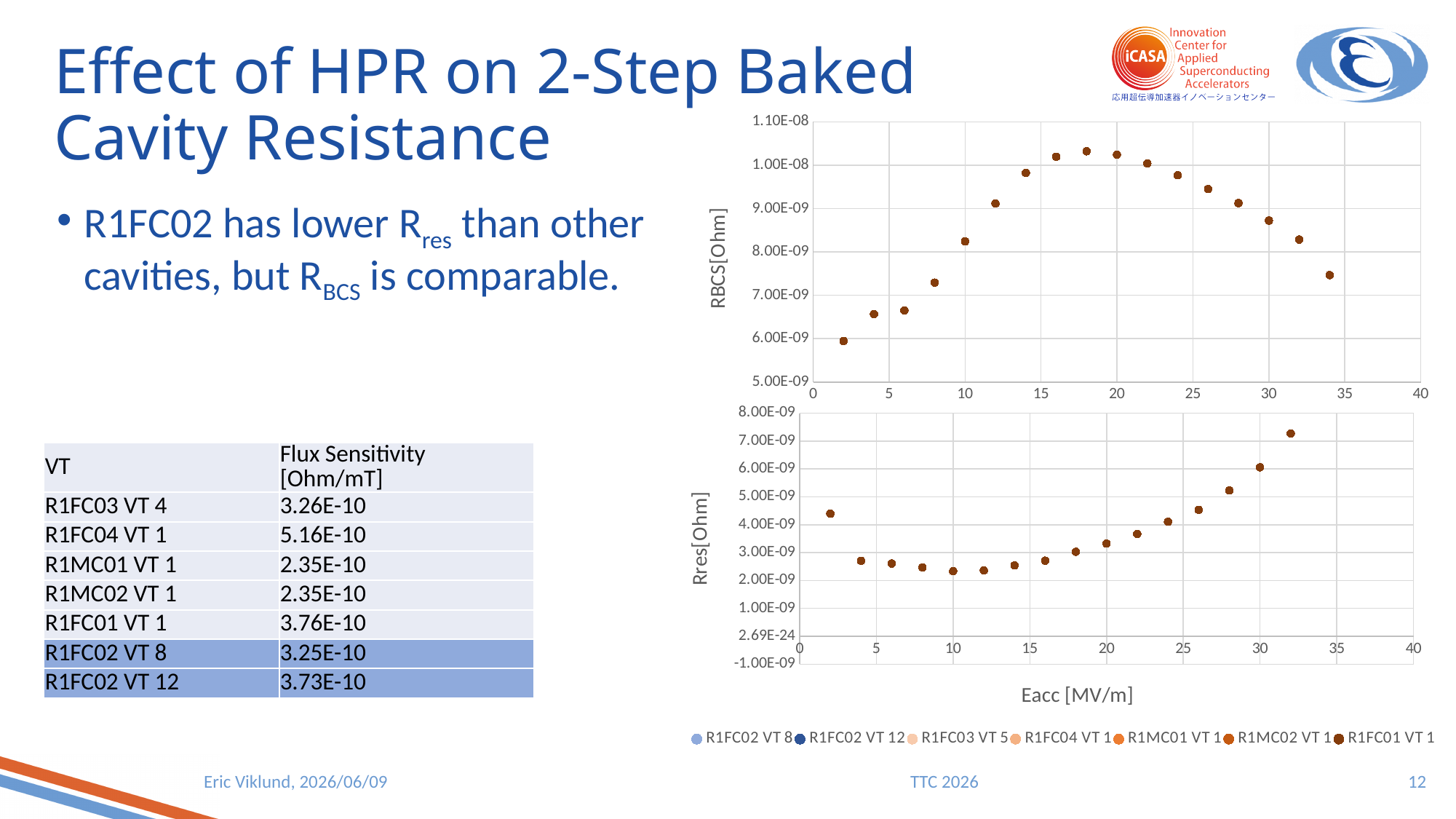
How many series does the legend below the charts list? 7 In the bottom chart, do the Rres values rise or fall as Eacc increases from 20 to 32 MV/m? rise What is the x-axis label shown under the bottom chart? Eacc [MV/m] In the bottom chart, is the Rres value at Eacc = 2 MV/m greater or less than 4.00E-09? greater In the top chart, is the RBCS value at Eacc = 2 MV/m greater or less than 7.00E-09? less In the top chart, is the RBCS value at Eacc = 34 MV/m greater or less than 8.00E-09? less What kind of chart is the top chart (RBCS vs Eacc)? scatter chart In the top chart, do the RBCS values rise or fall as Eacc increases from 20 to 34 MV/m? fall What kind of chart is the bottom chart (Rres vs Eacc)? scatter chart